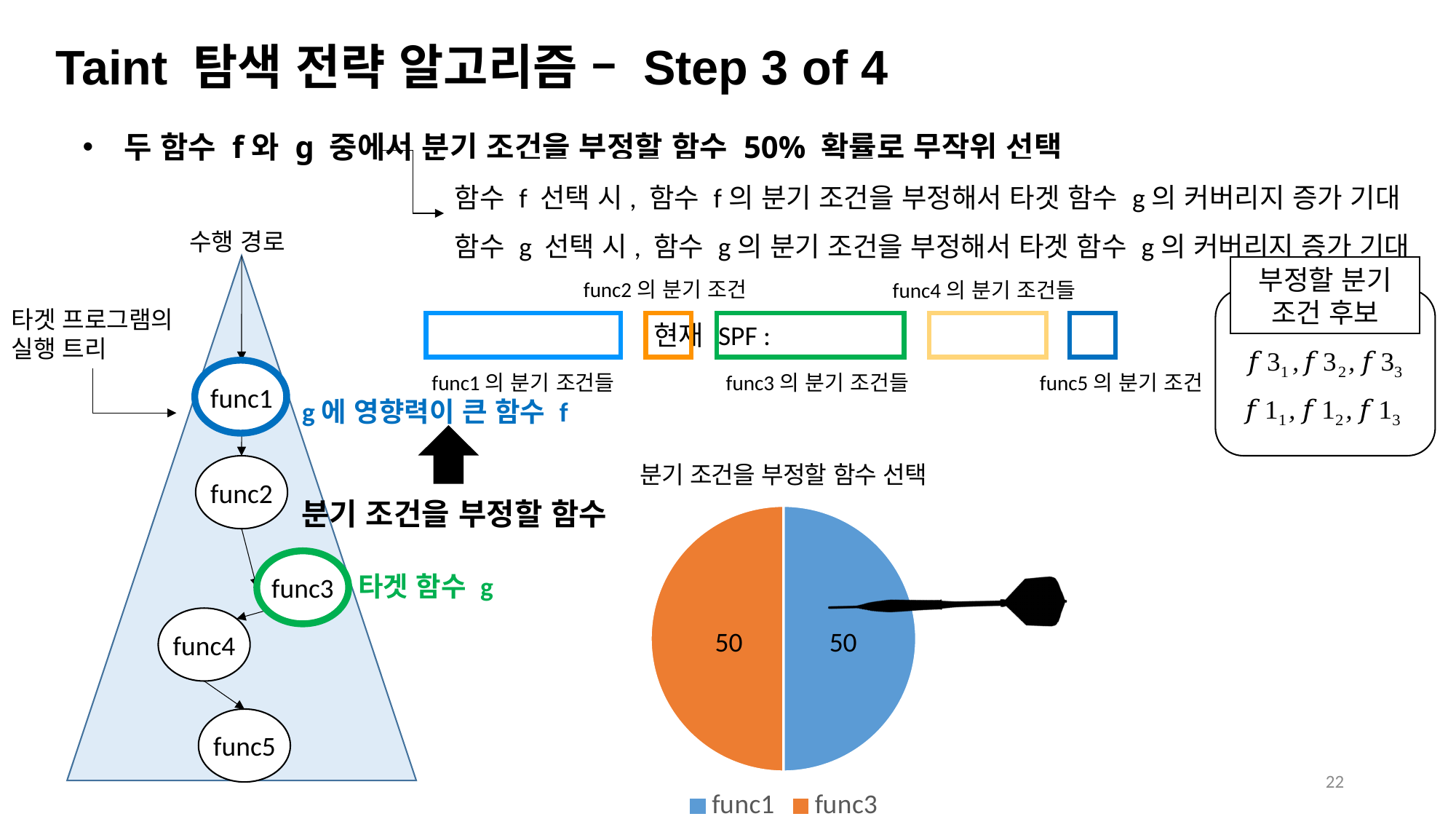
How many entries does the pie chart's legend list? 2 What share of the pie does the func1 slice represent? 50% What share of the pie does the func3 slice represent? 50% What is the total of the two values shown in the pie chart? 100 What is the value shown for func3 in the pie chart? 50 What is the value shown for func1 in the pie chart? 50 What is the title of the pie chart? 분기 조건을 부정할 함수 선택 How many slices does the pie chart have? 2 Which colour represents func3 in the pie chart? orange What is the difference between the values for func1 and func3 in the pie chart? 0 What kind of chart is shown on the slide? pie chart Are the values for func1 and func3 in the pie chart equal? yes